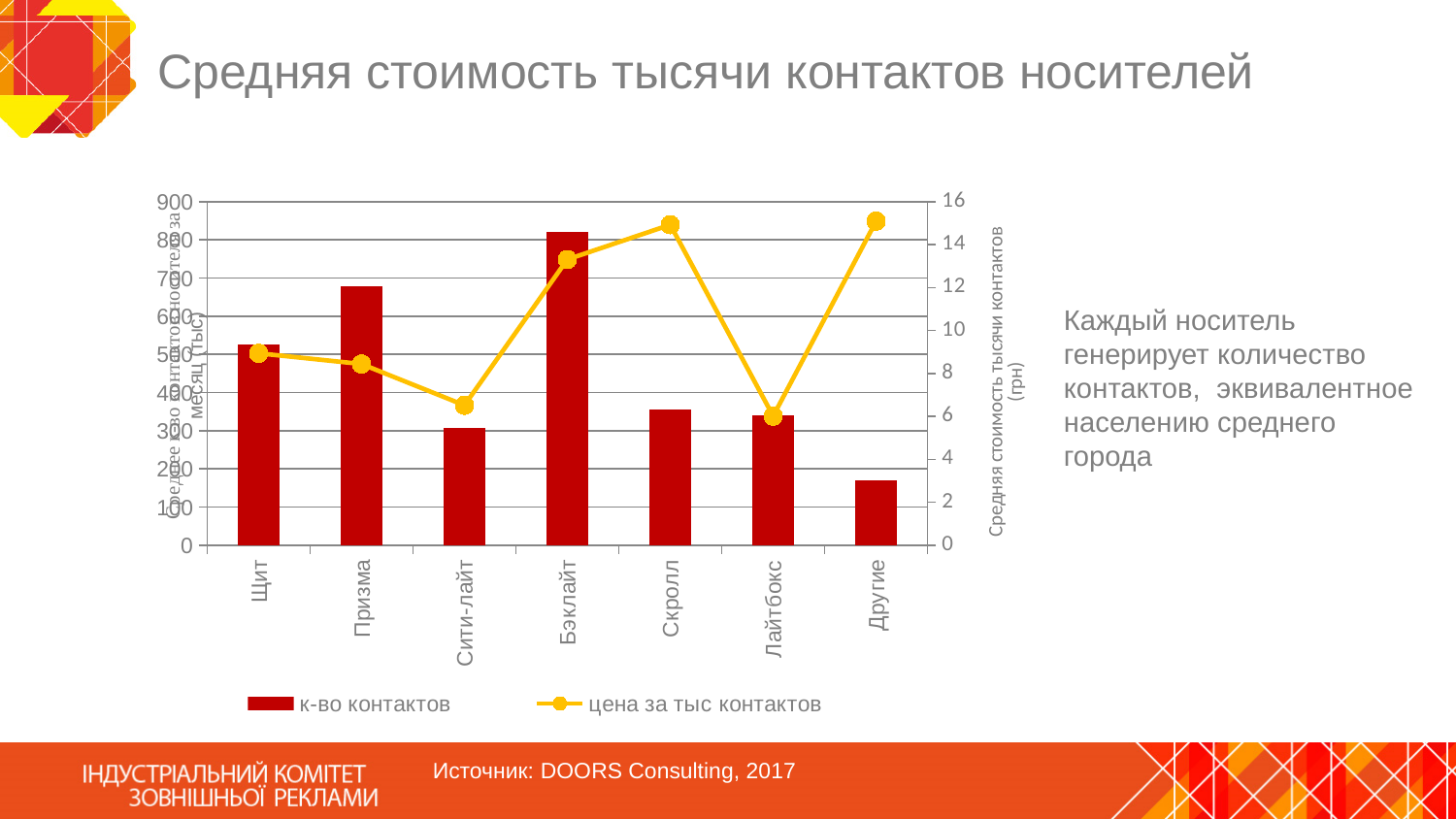
Which has a larger к-во контактов value, Призма or Щит? Призма Is the к-во контактов value for Бэклайт greater or less than 700? greater Is the к-во контактов value for Сити-лайт greater or less than 400? less Which category has the highest value for к-во контактов? Бэклайт How many categories are shown on the x axis of the chart? 7 Is the цена за тыс контактов value for Бэклайт greater or less than 12? greater Which category has the lowest value for к-во контактов? Другие What type of chart is shown on the slide? Combined bar and line chart How many series does the chart legend list? 2 Which series is shown as a line in the chart? цена за тыс контактов